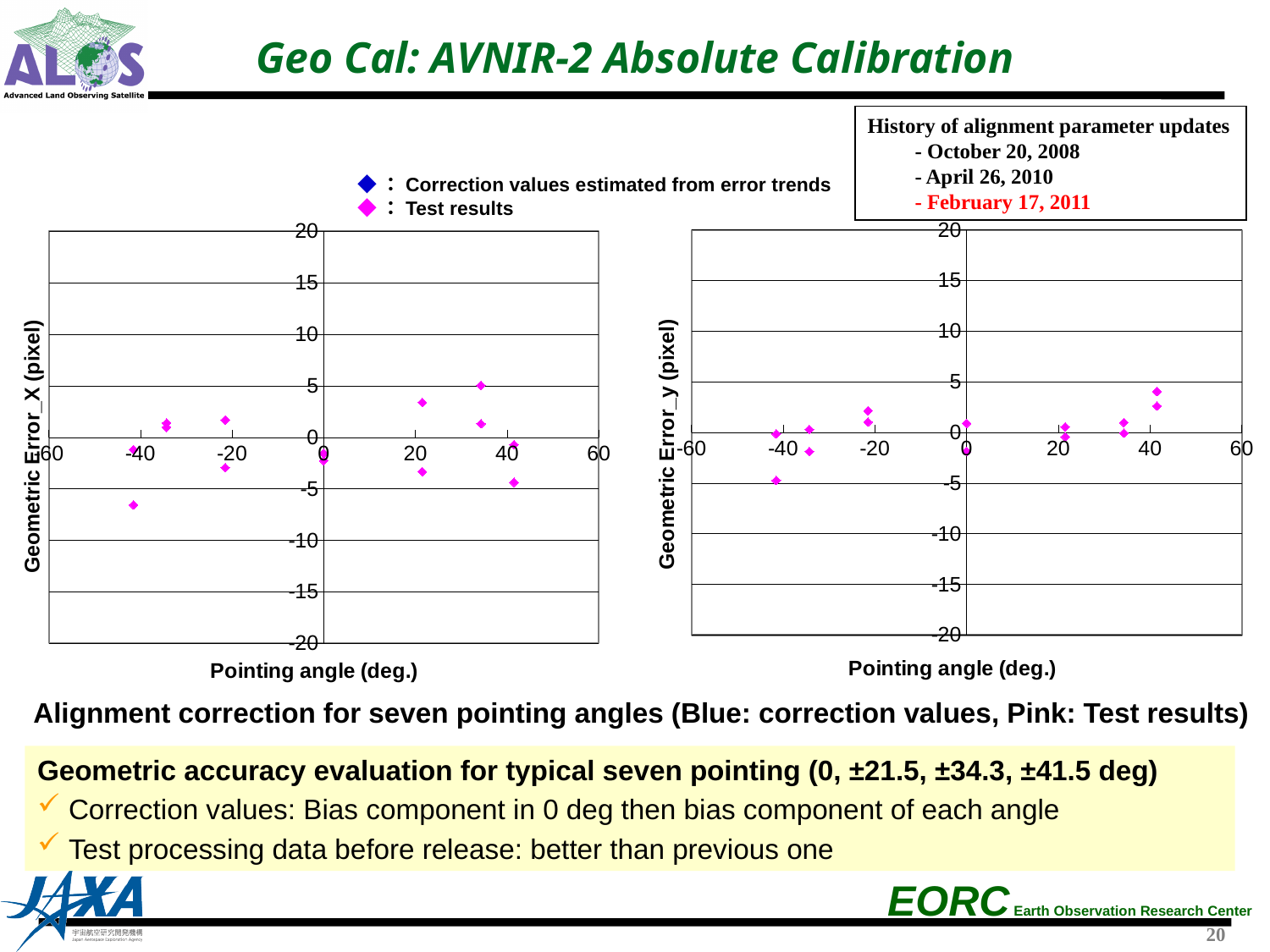
What is the y-axis label of the left chart? Geometric Error_X (pixel) What is the x-axis label of the right chart (Geometric Error_y)? Pointing angle (deg.) On the left chart (Geometric Error_X), do any plotted points lie above 10 pixels? No How many tick labels are shown on the x-axis of the right chart (Geometric Error_y)? 7 On the right chart (Geometric Error_y), do any plotted points lie below -10 pixels? No On the right chart (Geometric Error_y), is the lowest point near a pointing angle of -40 deg greater or less than 0 pixels? less What is the maximum value shown on the y-axis of the left chart (Geometric Error_X)? 20 How many series does the legend above the charts list? 2 What kind of chart is the left chart (Geometric Error_X)? Scatter chart